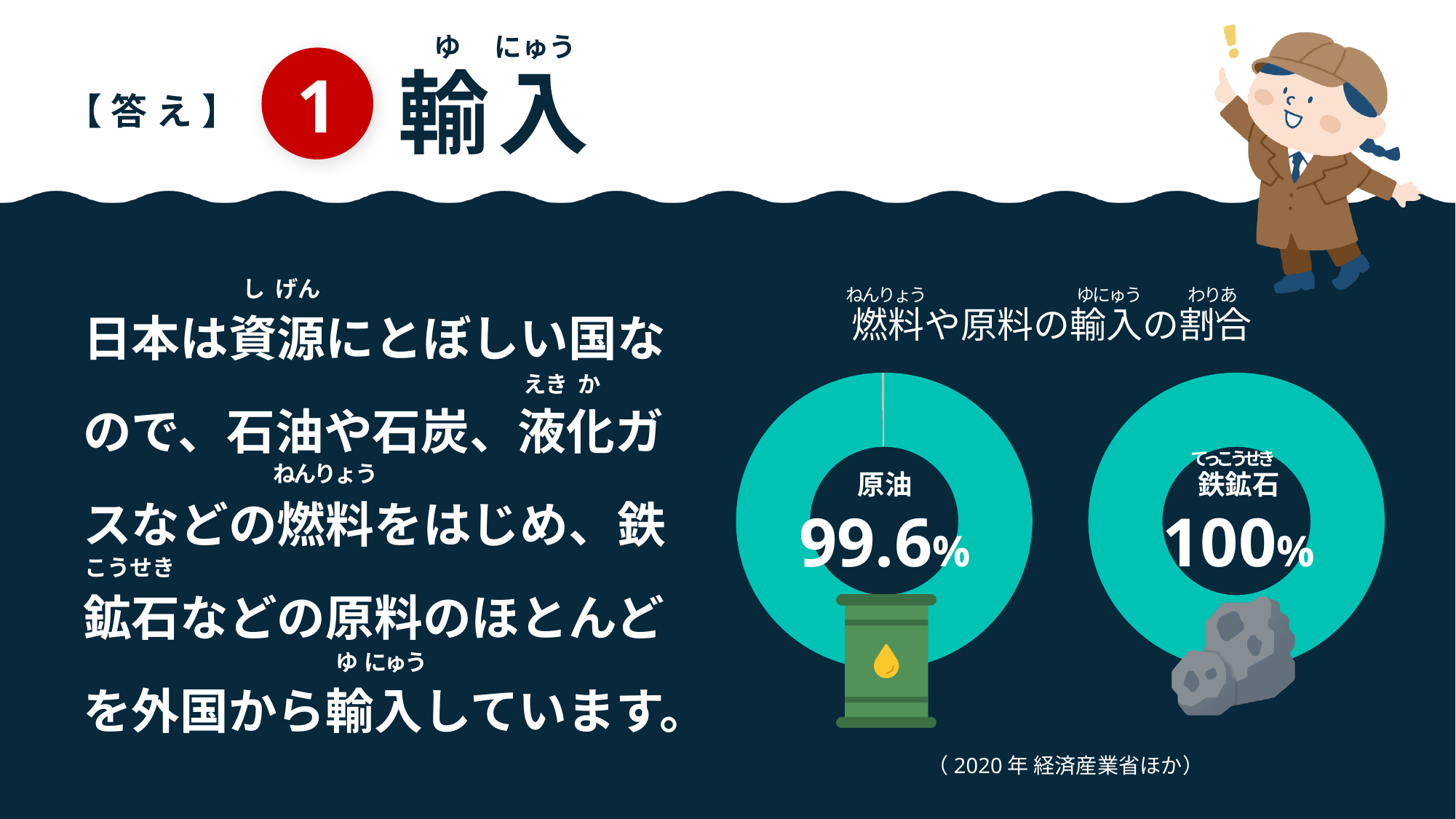
What year and source are cited below the charts? 2020年 経済産業省ほか How many donut charts are shown on the slide? 2 What is the title above the donut charts? 燃料や原料の輸入の割合 What is the import share shown for 鉄鉱石 (iron ore) in the right donut chart? 100% Which of the two items, 原油 or 鉄鉱石, has the higher import share? 鉄鉱石 What share of the 原油 donut is not imported (the remaining portion)? 0.4% What kind of chart is used to show the import shares of 原油 and 鉄鉱石? Donut (pie) chart What is the difference between the import share of 鉄鉱石 and that of 原油? 0.4% Is the import share for 原油 greater or less than 50%? greater What is the import share shown for 原油 (crude oil) in the left donut chart? 99.6% Which item has the lower import share, 原油 or 鉄鉱石? 原油